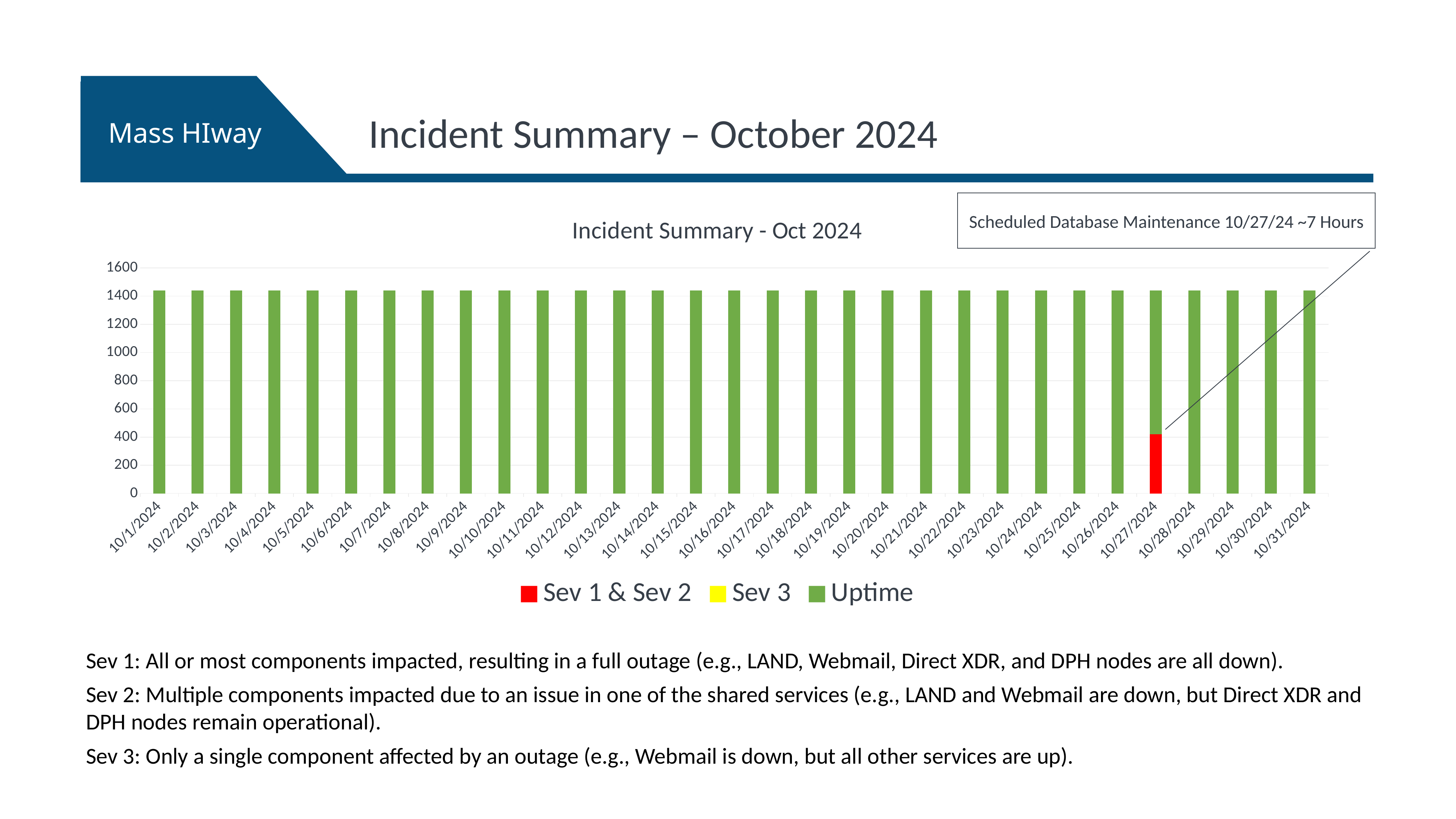
Is the Uptime value for 10/27/2024 greater or less than 1200? less Is the Sev 1 & Sev 2 value for 10/27/2024 greater or less than 600? less How many series does the chart legend list? 3 Is the Sev 1 & Sev 2 value for 10/27/2024 greater or less than 200? greater Which is larger on 10/27/2024, the Uptime segment or the Sev 1 & Sev 2 segment? Uptime Which date is the only one with a Sev 1 & Sev 2 (red) segment in its bar? 10/27/2024 What is the title of the chart? Incident Summary - Oct 2024 How many dates are plotted along the x axis of the chart? 31 What kind of chart is shown on the slide? bar chart Which date has the lowest Uptime value? 10/27/2024